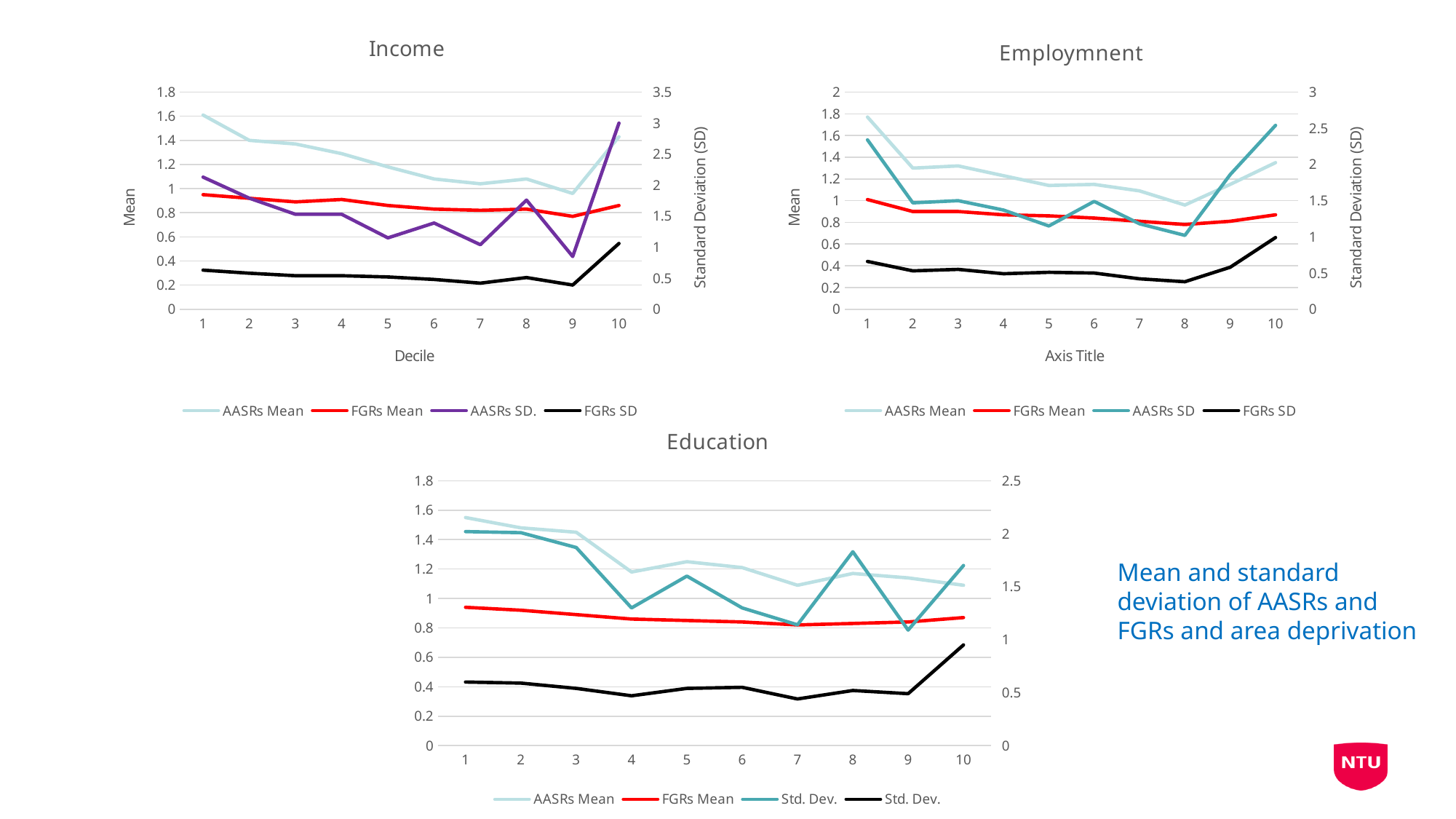
In the Education chart, at which decile is the black Std. Dev. line highest? 10 In the Income chart, at which decile is the AASRs Mean highest? 1 In the Income chart, which is larger at decile 1: the AASRs Mean or the FGRs Mean? AASRs Mean In the Income chart, is the AASRs Mean at decile 1 greater or less than 1.4? greater What is the x-axis title of the Income chart? Decile What kind of chart is the Income chart? line chart How many series does the legend of the Employmnent chart list? 4 In the Employmnent chart, is the AASRs SD at decile 10 greater or less than 2? greater How many deciles are plotted along the x axis of the Education chart? 10 In the Employmnent chart, at which decile is the AASRs SD highest? 10 In the Employmnent chart, at which decile is the AASRs Mean lowest? 8